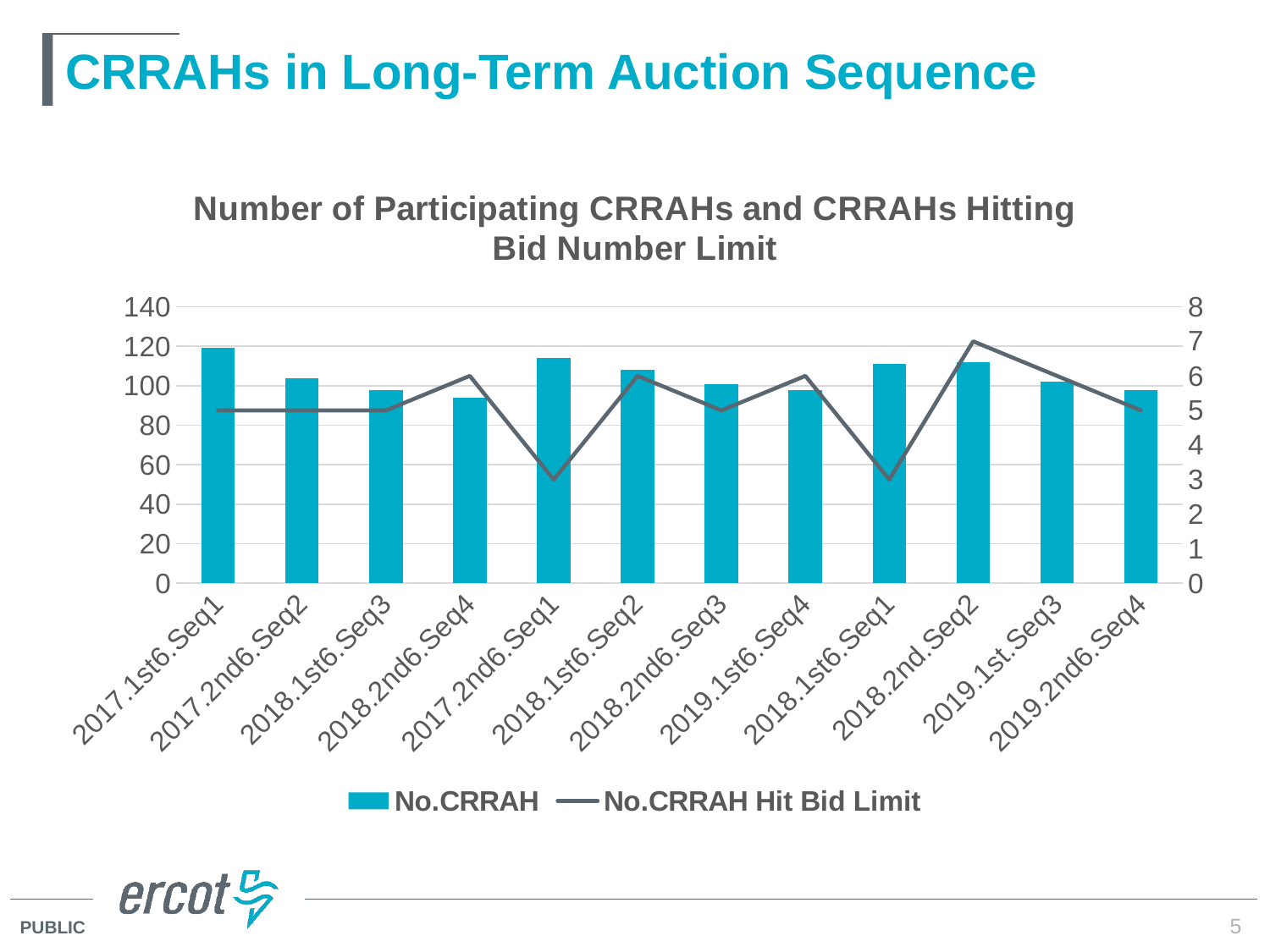
What is the title of the chart? Number of Participating CRRAHs and CRRAHs Hitting Bid Number Limit How many categories are shown on the x axis of the chart? 12 What is the No.CRRAH Hit Bid Limit value for 2017.2nd6.Seq1? 3 Which category has the highest No.CRRAH bar? 2017.1st6.Seq1 Which has a larger No.CRRAH value, 2017.1st6.Seq1 or 2018.2nd6.Seq4? 2017.1st6.Seq1 Is the No.CRRAH value for 2018.2nd6.Seq4 greater or less than 100? less What kind of chart is used for the No.CRRAH series? Bar chart What is the No.CRRAH Hit Bid Limit value for 2017.1st6.Seq1? 5 Which category has the highest value for No.CRRAH Hit Bid Limit? 2018.2nd.Seq2 Is the No.CRRAH value for 2017.1st6.Seq1 greater or less than 100? greater What is the No.CRRAH Hit Bid Limit value for 2018.2nd.Seq2? 7 How many series does the legend list? 2